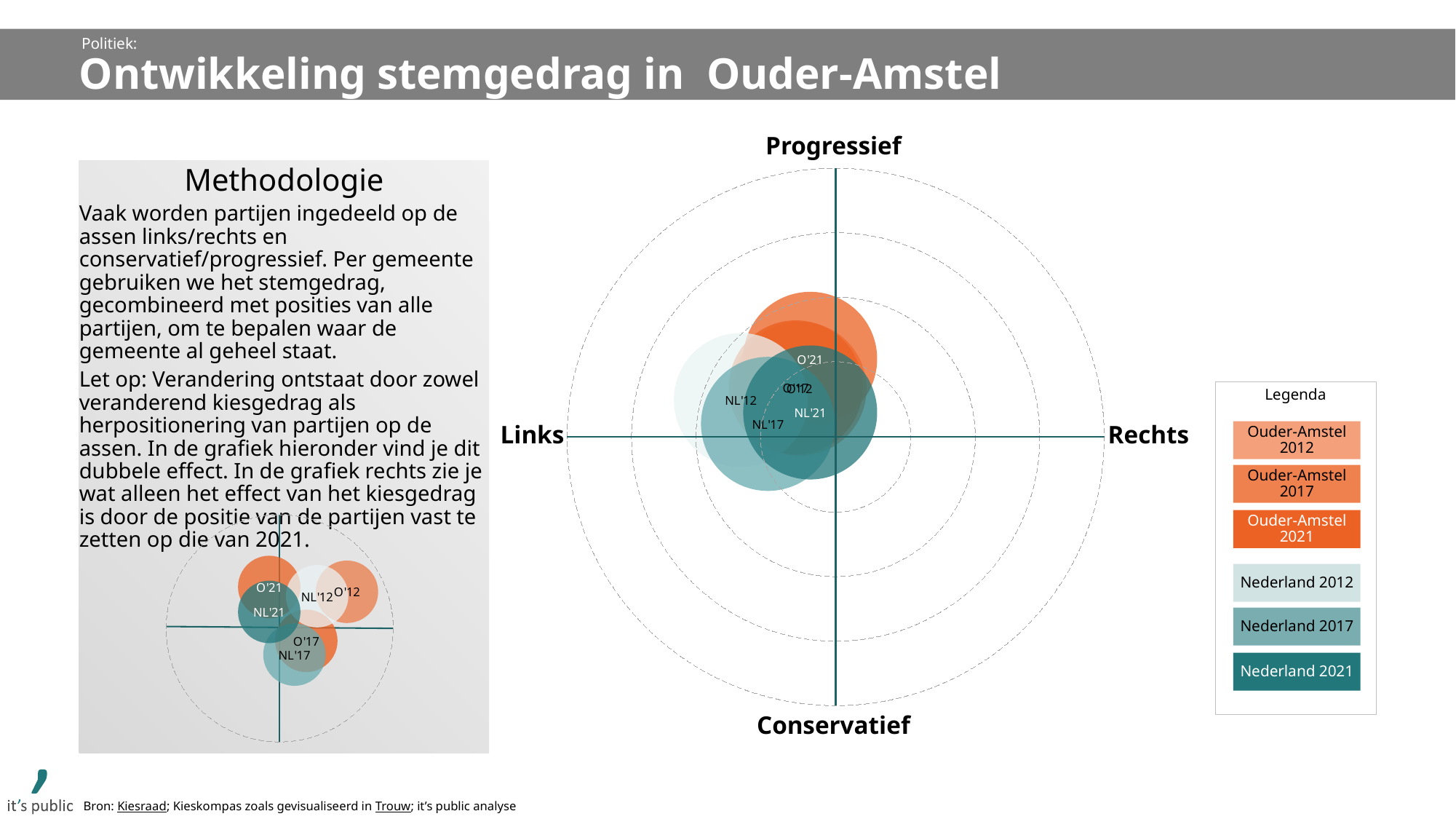
How many labelled bubbles are plotted in the small chart inside the Methodologie box? 6 What is the title of the slide containing the charts? Ontwikkeling stemgedrag in Ouder-Amstel How many entries does the legend (Legenda) list for the large chart? 6 How many labelled bubbles are plotted in the large chart on the right? 6 In the large chart, which bubble is positioned higher, O'21 or NL'17? O'21 In the small chart inside the Methodologie box, which bubble is positioned furthest to the right? O'12 In the large chart, what are the labels at the left and right ends of the horizontal axis? Links and Rechts In the small chart inside the Methodologie box, which bubble is positioned lowest (most towards the conservative side)? NL'17 What kind of chart is the large chart on the right of the slide? bubble chart In the small chart inside the Methodologie box, which bubble is further to the left, O'21 or O'12? O'21 In the large chart, which bubble is positioned further to the left, NL'12 or NL'21? NL'12 In the large chart, which bubble is positioned highest (most towards Progressief)? O'21